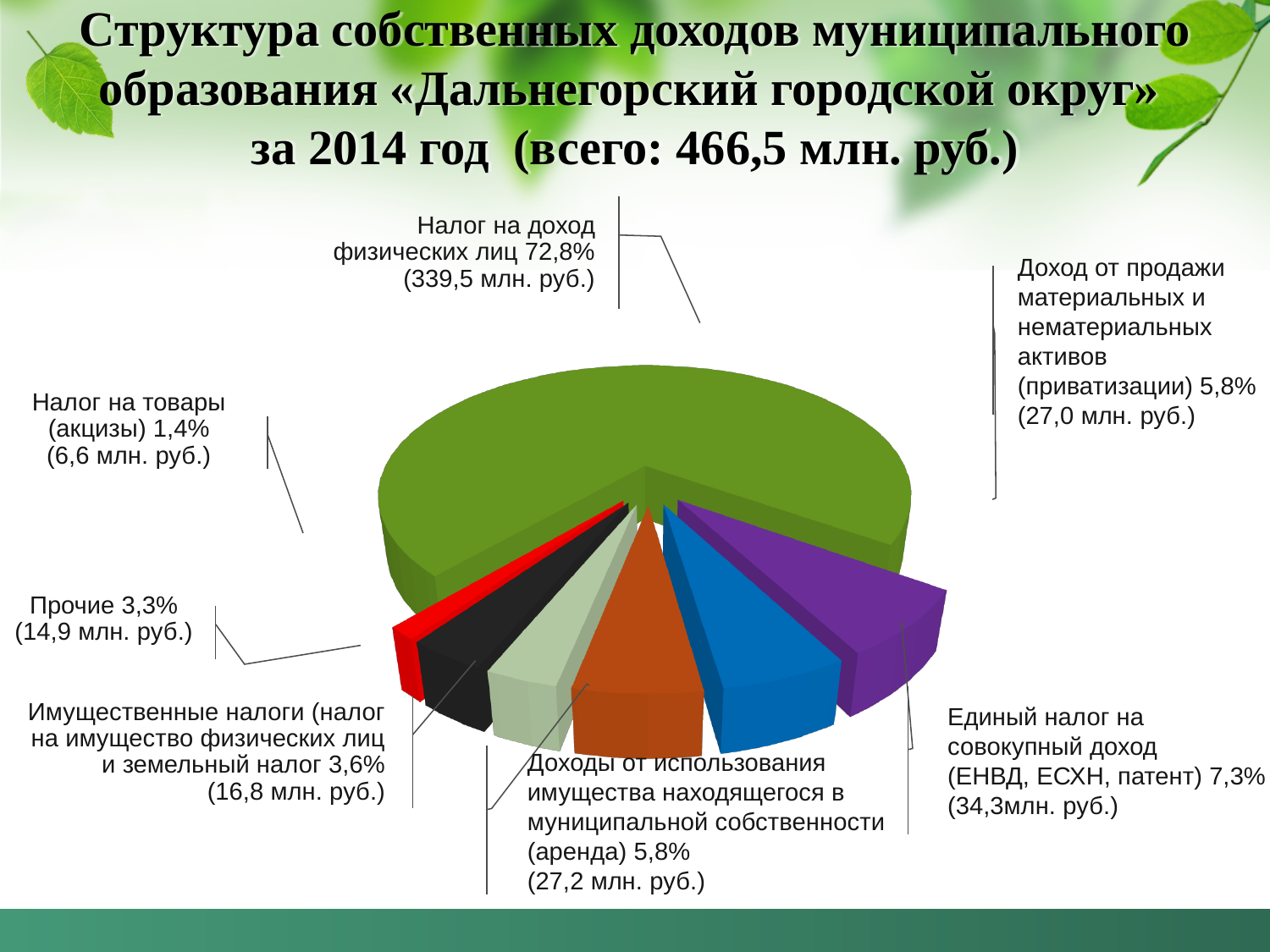
What percentage share is shown for Имущественные налоги? 3,6% Which category has the largest share of the pie? Налог на доход физических лиц Which category has the smallest share of the pie? Налог на товары (акцизы) What is the value in млн. руб. for Единый налог на совокупный доход (ЕНВД, ЕСХН, патент)? 34,3 млн. руб. What is the value in млн. руб. for Прочие? 14,9 млн. руб. What is the difference in млн. руб. between Налог на доход физических лиц and Единый налог на совокупный доход? 305,2 млн. руб. What share of the pie does Налог на доход физических лиц account for? 72,8% What total amount in млн. руб. is stated in the chart title for 2014? 466,5 млн. руб. What is the difference in percentage points between Прочие (3,3%) and Налог на товары (акцизы) (1,4%)? 1,9 Which is larger: the share for Единый налог на совокупный доход or the share for Доходы от использования имущества (аренда)? Единый налог на совокупный доход How many slices does the pie chart have? 7 What kind of chart is shown on the slide? pie chart